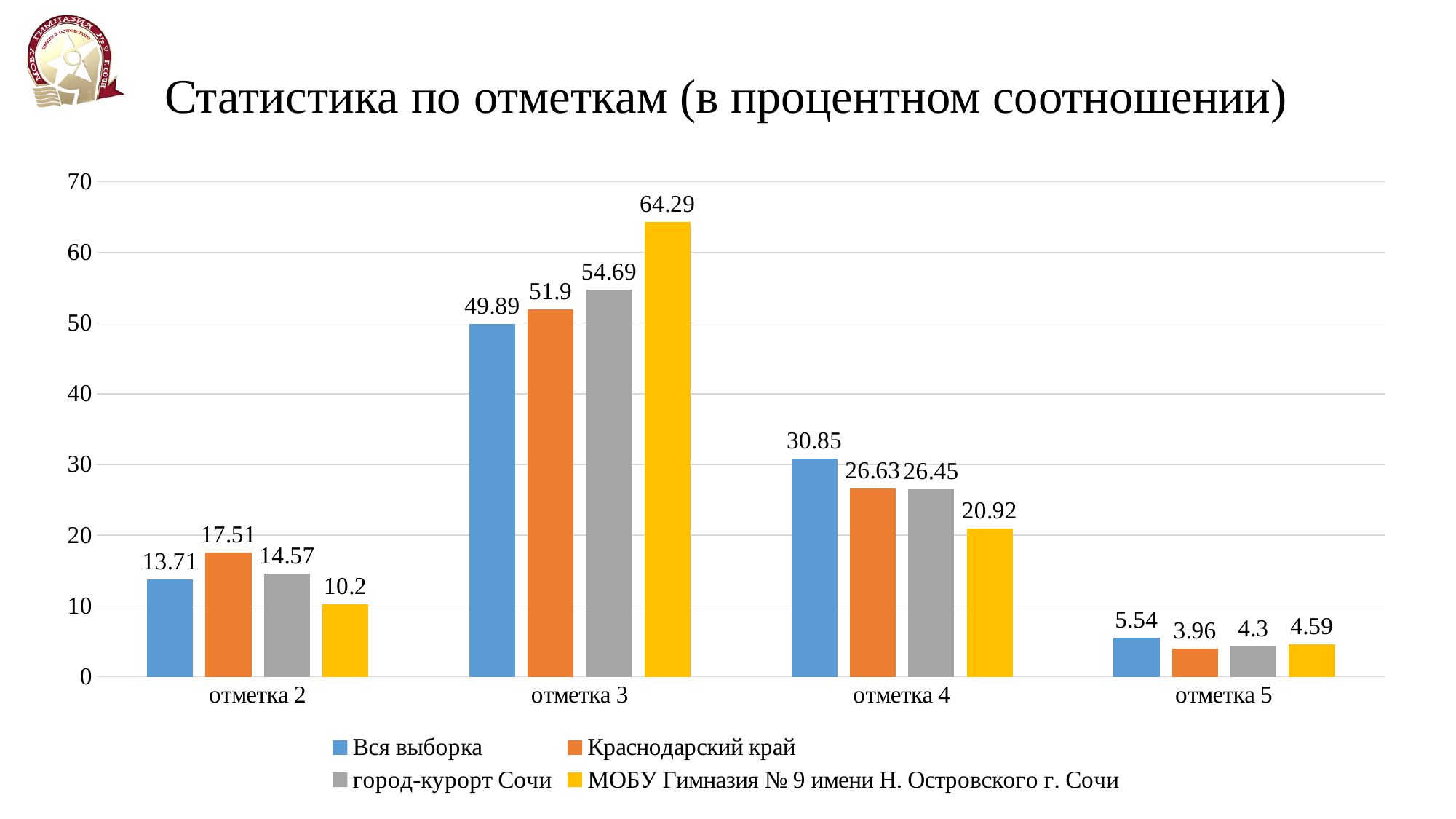
What is the value for город-курорт Сочи at отметка 5? 4.3 Which category has the highest value for the Вся выборка series? отметка 3 What is the difference between the МОБУ Гимназия № 9 value and the Вся выборка value at отметка 3? 14.4 What is the value for Вся выборка at отметка 4? 30.85 Which category has the lowest value for the Краснодарский край series? отметка 5 What is the value for Краснодарский край at отметка 2? 17.51 How many series does the legend list? 4 How many categories are shown on the x axis? 4 At отметка 4, which is larger: Вся выборка or МОБУ Гимназия № 9 имени Н. Островского г. Сочи? Вся выборка What is the title of the slide? Статистика по отметкам (в процентном соотношении) What is the value for МОБУ Гимназия № 9 имени Н. Островского г. Сочи at отметка 3? 64.29 What kind of chart is shown on the slide? bar chart